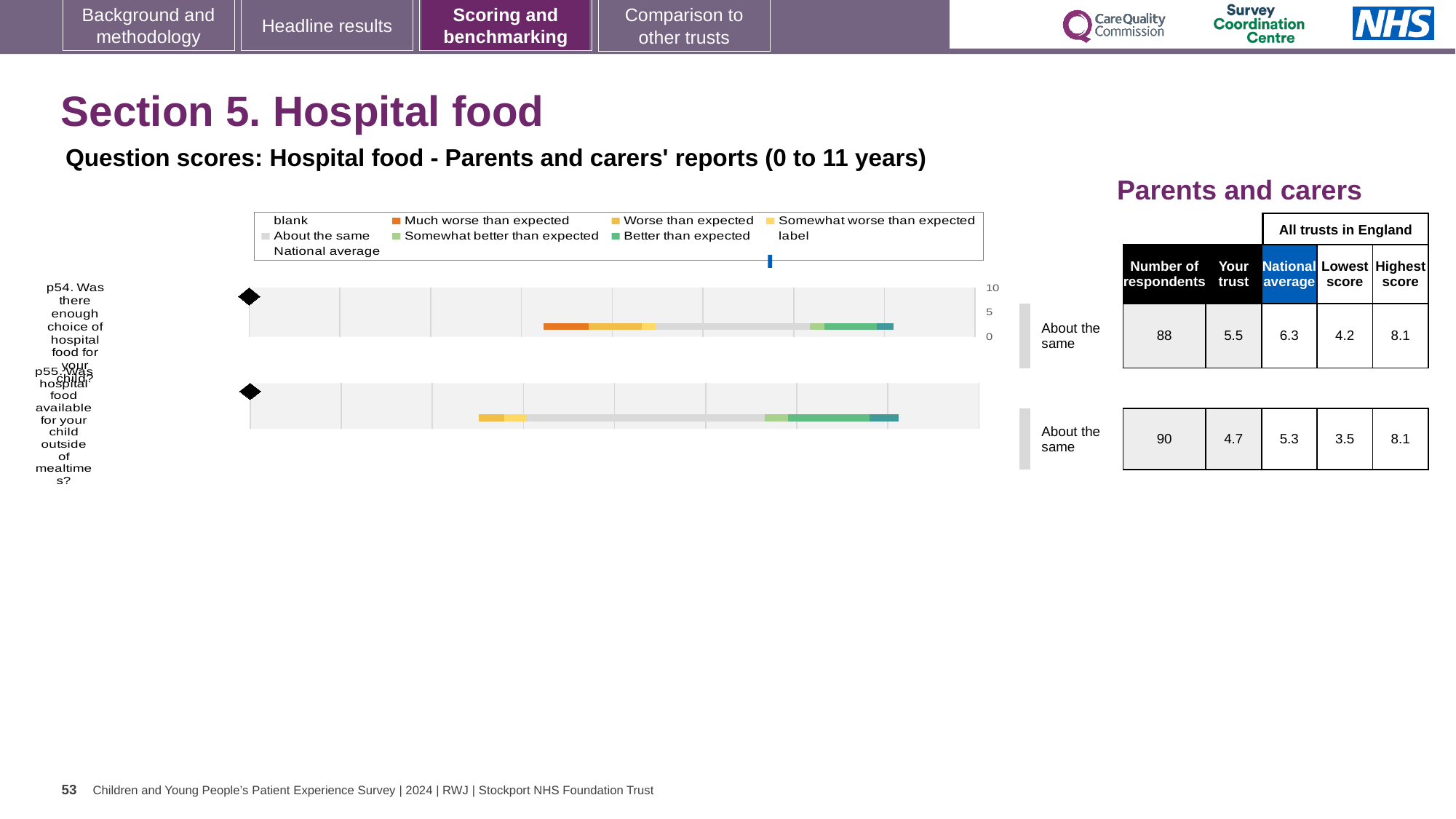
What is the 'Your trust' score for p55 (hospital food available outside of mealtimes)? 4.7 What benchmark category is given for both p54 and p55? About the same Which legend entry is shown in orange in the hospital food chart? Much worse than expected What is the maximum value shown on the chart's score axis? 10 How many questions (categories) are plotted in the hospital food chart? 2 What kind of chart is used to show the question scores for hospital food? Bar chart Which question has the higher 'Your trust' score, p54 or p55? p54 What is the national average score for p54? 6.3 What is the lowest score across all trusts in England for p55? 3.5 How many respondents answered p55? 90 What is the difference between the 'Your trust' scores for p54 and p55? 0.8 What is the 'Your trust' score for p54 (enough choice of hospital food for your child)? 5.5